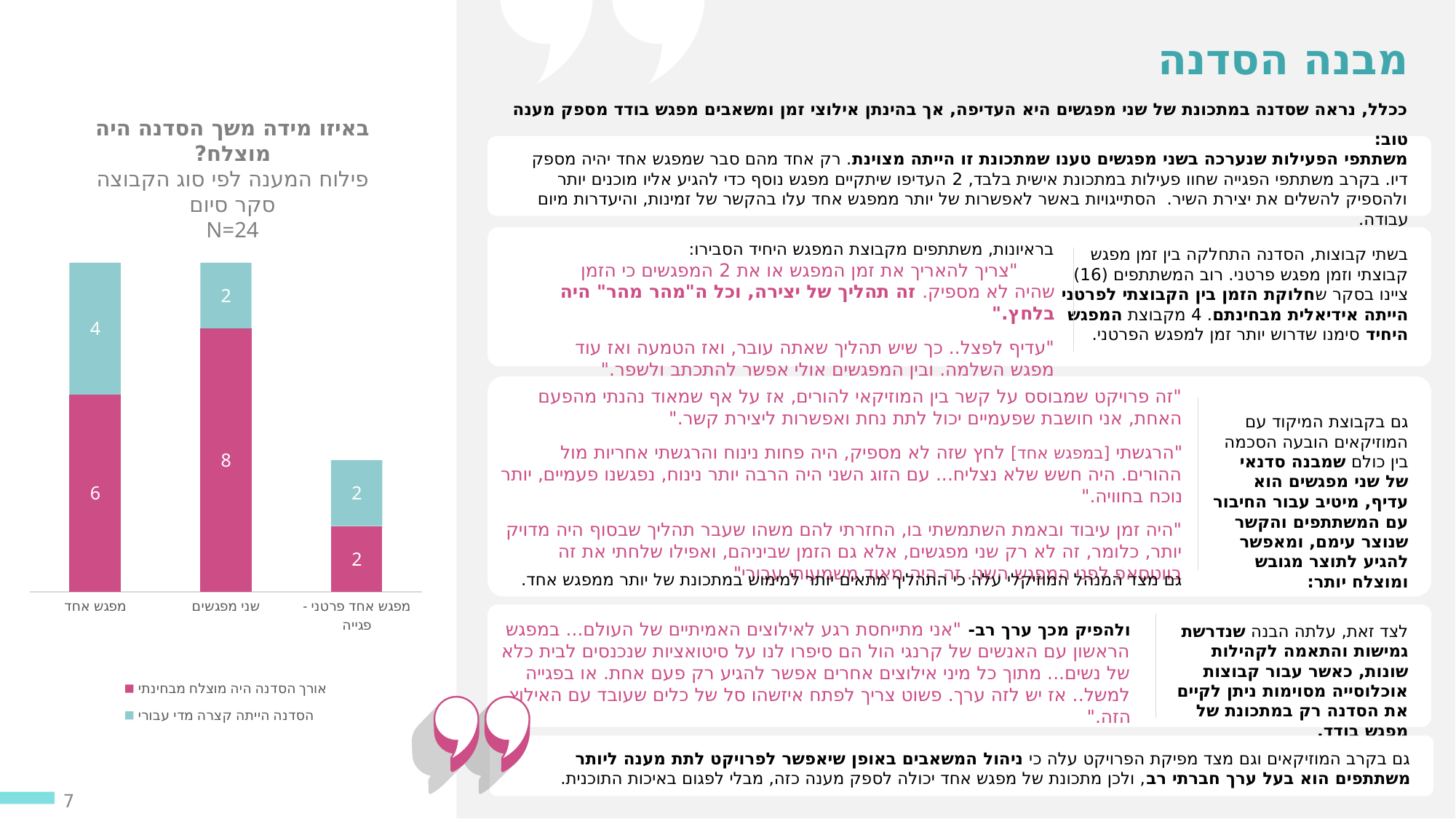
What is the difference between the "אורך הסדנה היה מוצלח מבחינתי" values for "שני מפגשים" and "מפגש אחד"? 2 Which category has the highest value for the series "אורך הסדנה היה מוצלח מבחינתי"? שני מפגשים What sample size (N) is stated in the chart title? N=24 How many categories are shown on the x axis of the chart? 3 What is the value of the series "אורך הסדנה היה מוצלח מבחינתי" for the category "מפגש אחד"? 6 How many series does the chart legend list? 2 What is the total of the stacked bar for "שני מפגשים"? 10 What is the total of the stacked bar for "מפגש אחד פרטני - פגייה"? 4 What type of chart is shown on the slide? Stacked bar chart What is the value of the series "הסדנה הייתה קצרה מדי עבורי" for the category "שני מפגשים"? 2 What is the value of the series "אורך הסדנה היה מוצלח מבחינתי" for the category "שני מפגשים"? 8 What is the value of the series "הסדנה הייתה קצרה מדי עבורי" for the category "מפגש אחד"? 4